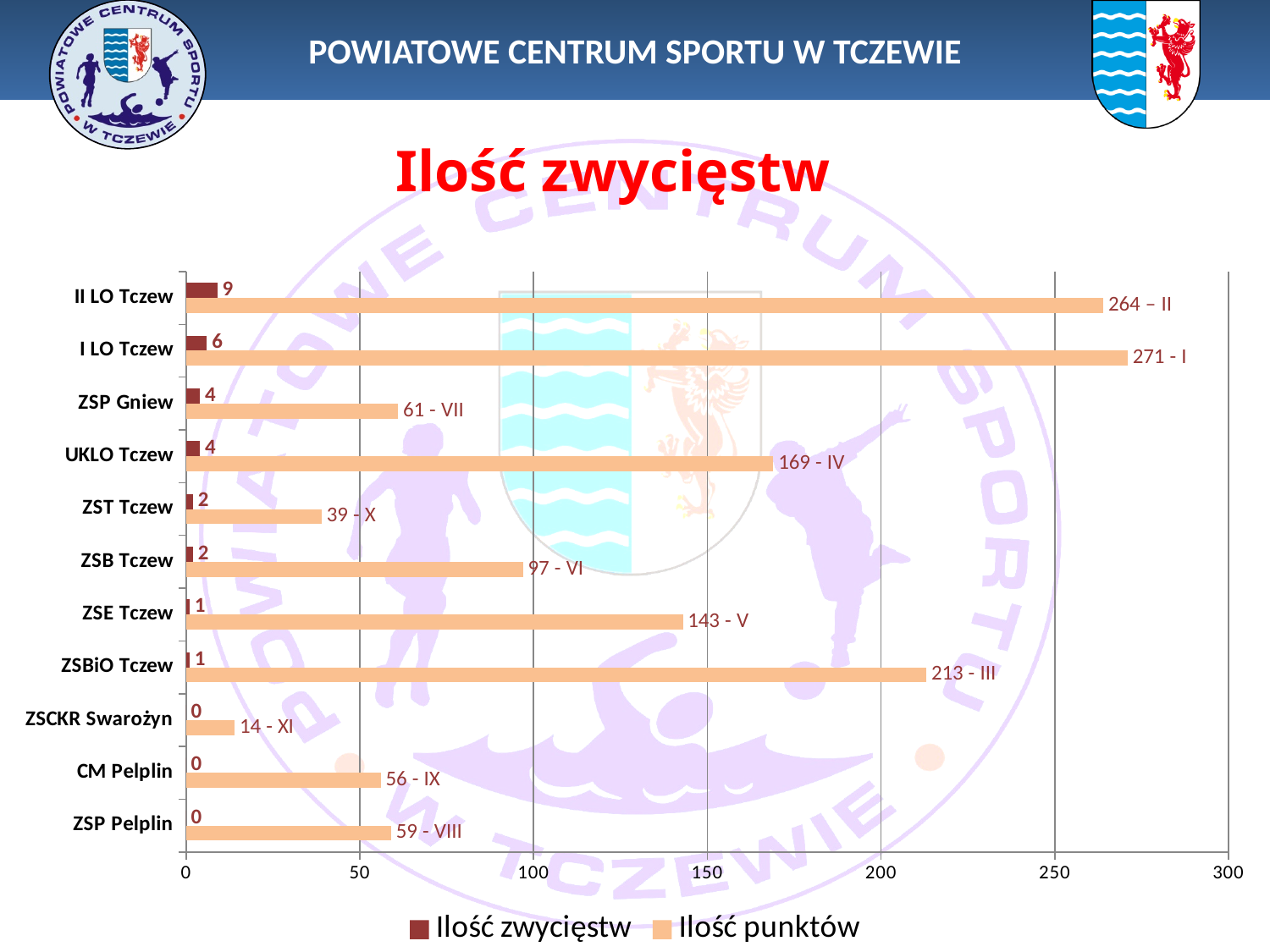
How many schools (categories) are shown on the chart? 11 What kind of chart is shown on the slide? bar chart What is the title of the chart? Ilość zwycięstw How many series does the legend list? 2 What data label is shown on the Ilość punktów bar for ZSCKR Swarożyn? 14 - XI Which has a larger Ilość punktów value, UKLO Tczew or ZSE Tczew? UKLO Tczew What is the value of Ilość zwycięstw for II LO Tczew? 9 Which school has the highest value of Ilość zwycięstw? II LO Tczew What data label is shown on the Ilość punktów bar for I LO Tczew? 271 - I Which school has the lowest value of Ilość punktów? ZSCKR Swarożyn What is the value of Ilość zwycięstw for I LO Tczew? 6 What is the difference in Ilość zwycięstw between II LO Tczew and I LO Tczew? 3